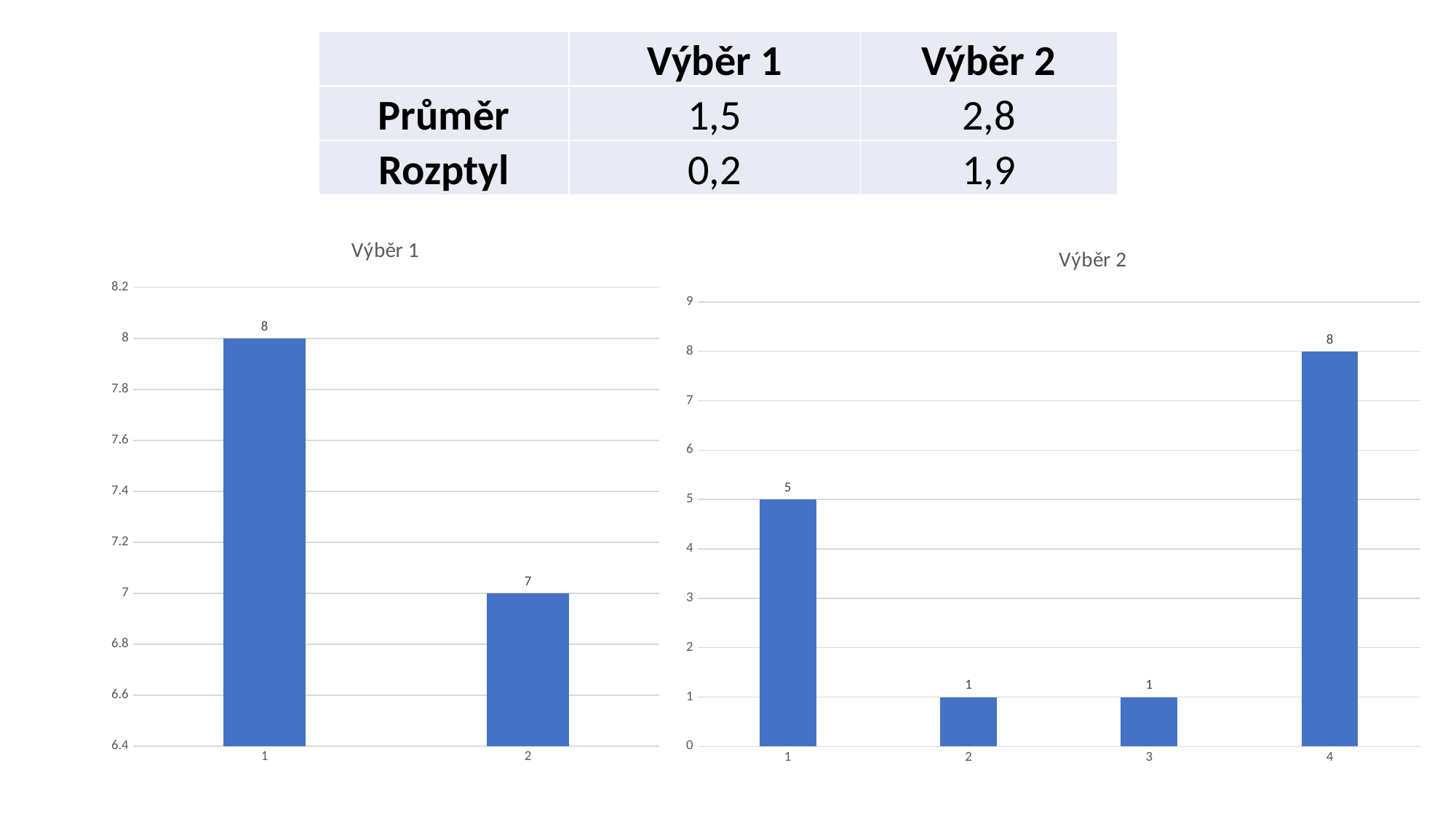
In the 'Výběr 2' chart, which is larger, the value for category 1 or the value for category 3? category 1 In the 'Výběr 2' chart, how many categories are plotted? 4 What kind of chart is the 'Výběr 2' chart? bar chart In the 'Výběr 2' chart, what is the value for category 4? 8 In the 'Výběr 1' chart, how many bars are plotted? 2 In the 'Výběr 1' chart, what is the value for category 1? 8 In the 'Výběr 1' chart, what is the value for category 2? 7 In the 'Výběr 2' chart, what is the difference between the values for category 4 and category 1? 3 In the 'Výběr 2' chart, what is the total of the values for categories 2 and 3? 2 In the 'Výběr 2' chart, which category has the highest value? 4 In the 'Výběr 2' chart, what is the value for category 1? 5 In the 'Výběr 1' chart, what is the difference between the values for category 1 and category 2? 1